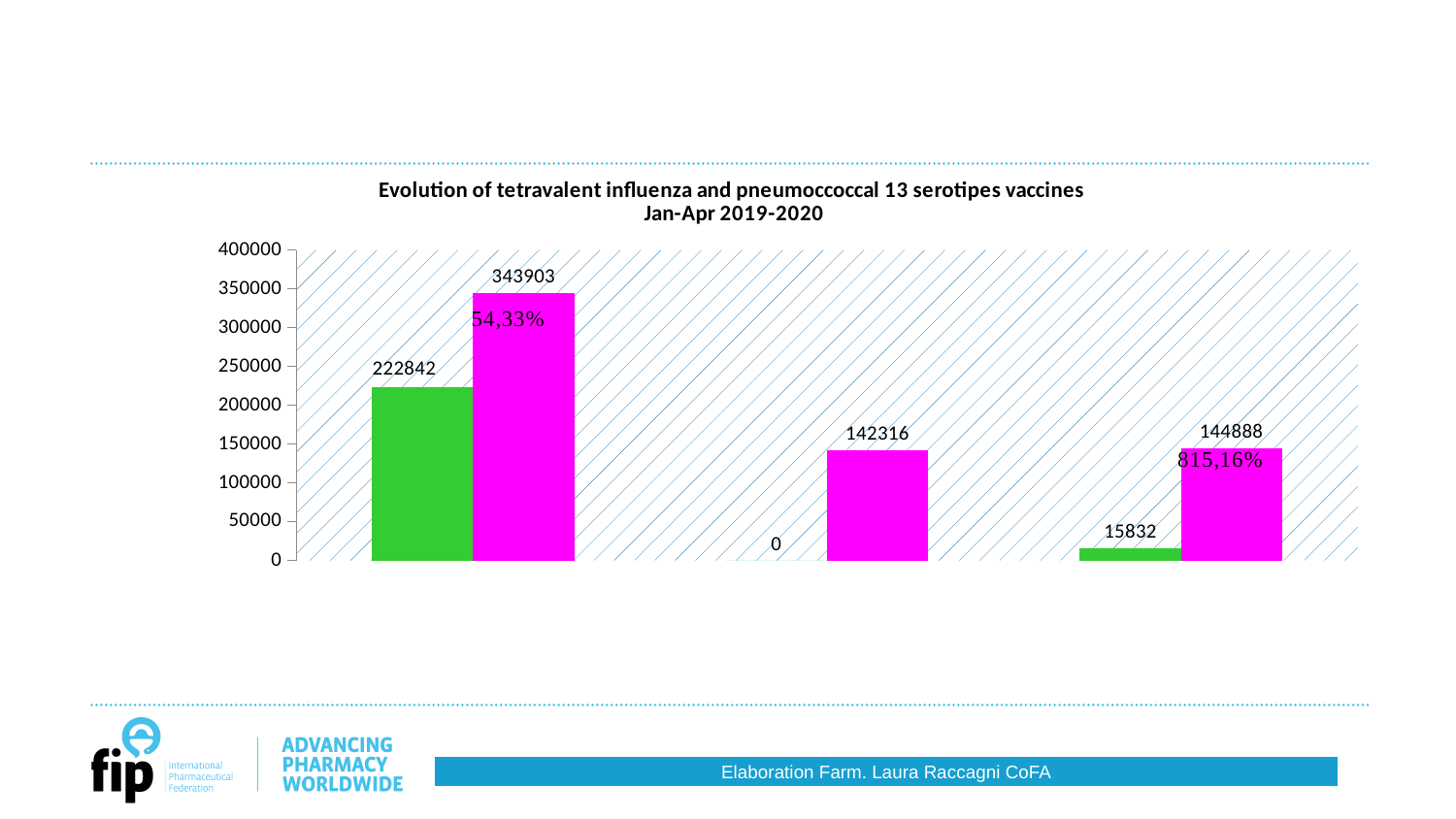
What is the value of the green bar in the third (rightmost) group of bars? 15832 What percentage label is shown on the magenta bar in the rightmost group? 815,16% Which bar has the highest value on the chart? the magenta bar in the first group (343903) What is the difference between the magenta bar and the green bar in the first (leftmost) group? 121061 What is the value of the magenta bar in the first (leftmost) group of bars? 343903 What is the value of the green bar in the first (leftmost) group of bars? 222842 Which is larger: the magenta bar in the middle group or the magenta bar in the rightmost group? the magenta bar in the rightmost group (144888) What is the title of the chart? Evolution of tetravalent influenza and pneumoccoccal 13 serotipes vaccines Jan-Apr 2019-2020 What is the value of the green bar in the middle group of bars? 0 What type of chart is shown on the slide? bar chart What is the value of the magenta bar in the third (rightmost) group of bars? 144888 What is the value of the magenta bar in the middle group of bars? 142316